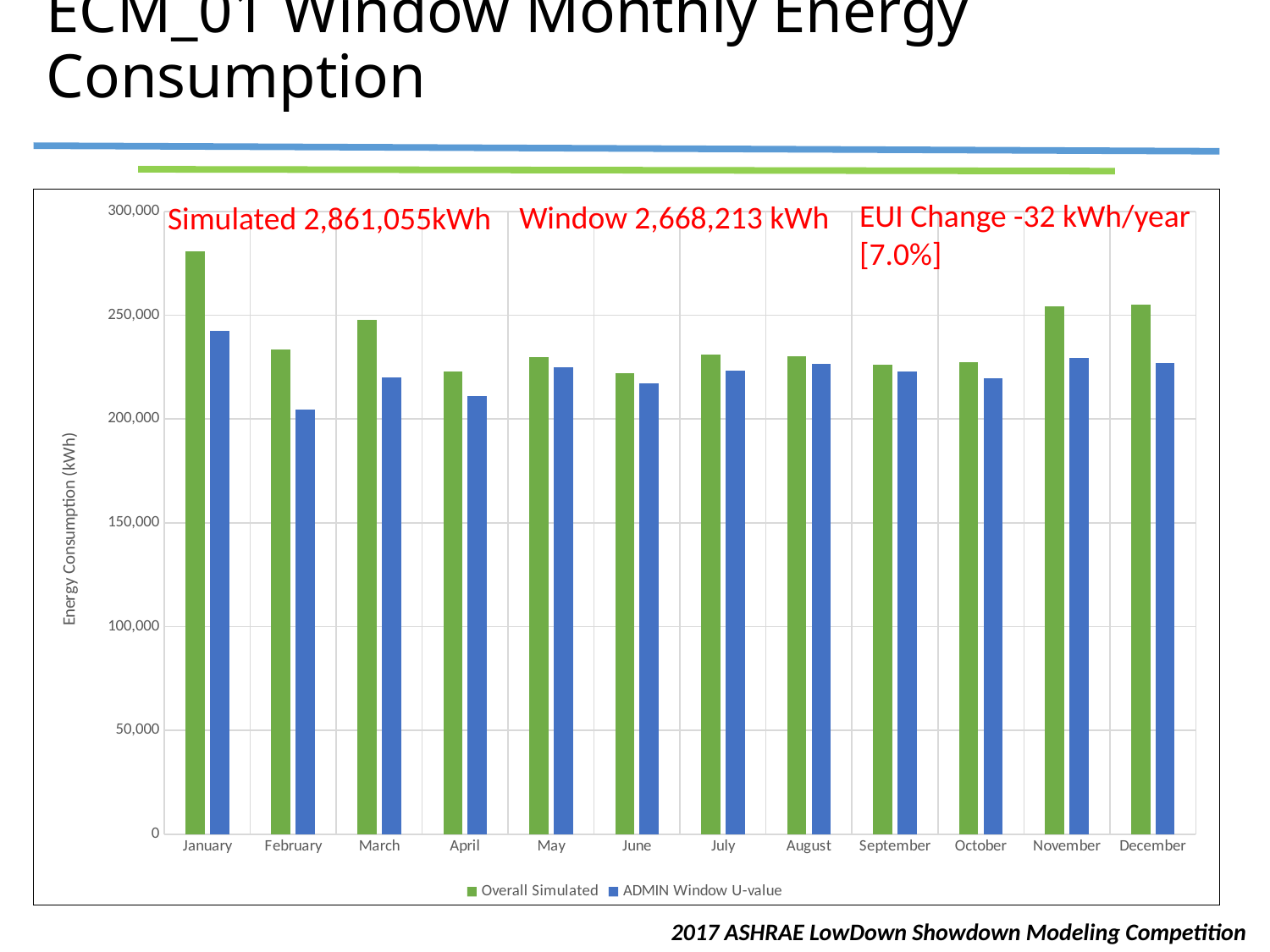
Which month has the lowest ADMIN Window U-value energy consumption? February Which month has the highest ADMIN Window U-value energy consumption? January Is the Overall Simulated value for January greater or less than 250,000? greater How many series does the legend list? 2 How many months are shown on the x axis? 12 Which month has the highest Overall Simulated energy consumption? January Is the Overall Simulated value for November greater or less than 250,000? greater In January, which is larger: Overall Simulated or ADMIN Window U-value? Overall Simulated Is the ADMIN Window U-value for February greater or less than 250,000? less What is the label on the y axis? Energy Consumption (kWh) Which colour represents the ADMIN Window U-value series? blue What kind of chart is shown on the slide? bar chart